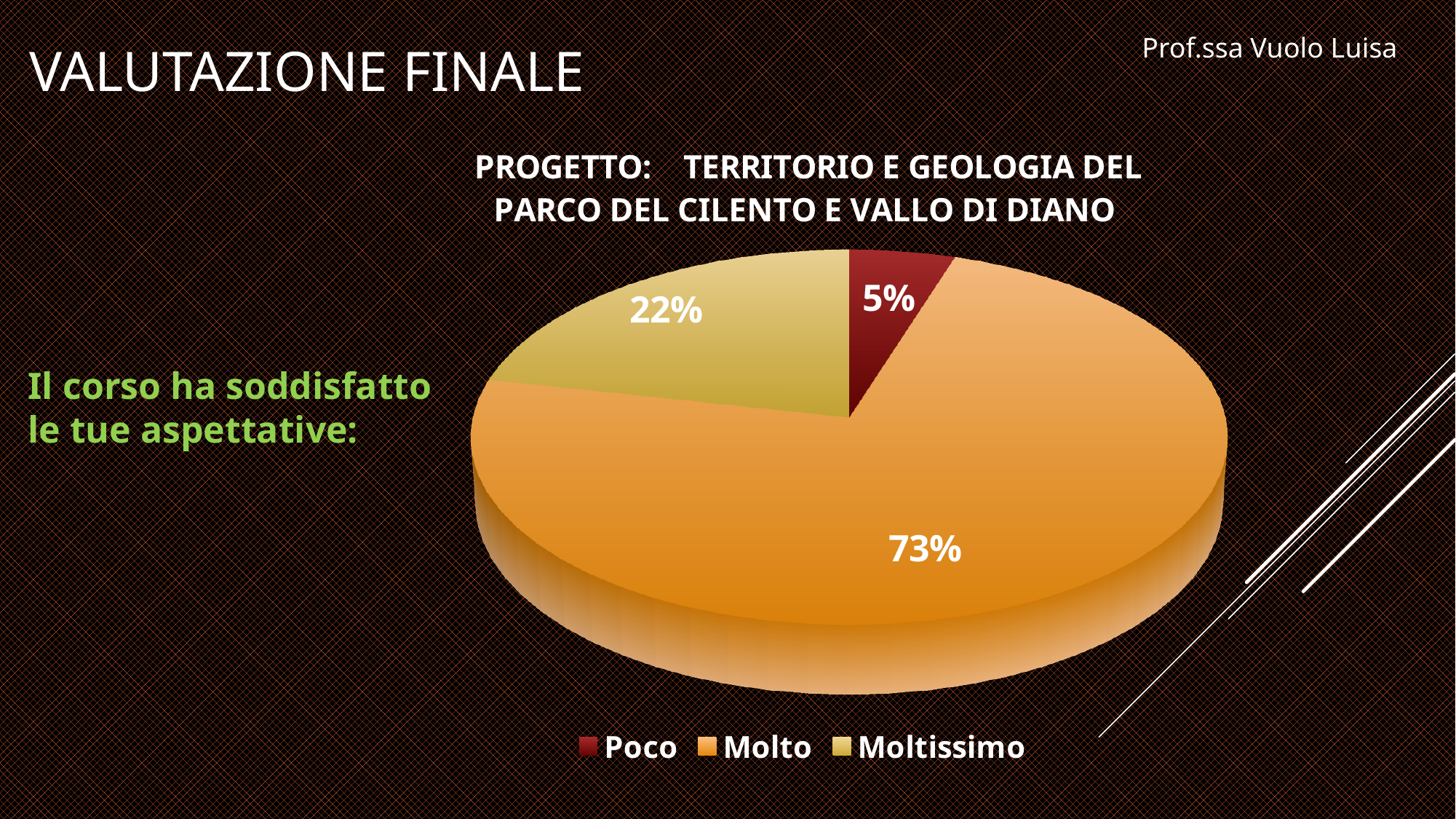
What percentage of the pie is labelled Molto? 73% What is the title of the chart? PROGETTO: TERRITORIO E GEOLOGIA DEL PARCO DEL CILENTO E VALLO DI DIANO What is the difference in percentage points between Moltissimo and Poco? 17 What is the difference in percentage points between Molto and Moltissimo? 51 Which category has the largest share of the pie? Molto What percentage of the pie is labelled Poco? 5% Which is larger, the share for Moltissimo or the share for Poco? Moltissimo How many categories does the legend list? 3 What kind of chart is shown on the slide? pie chart Which category has the smallest share of the pie? Poco Which legend entry is shown in dark red? Poco What percentage of the pie is labelled Moltissimo? 22%